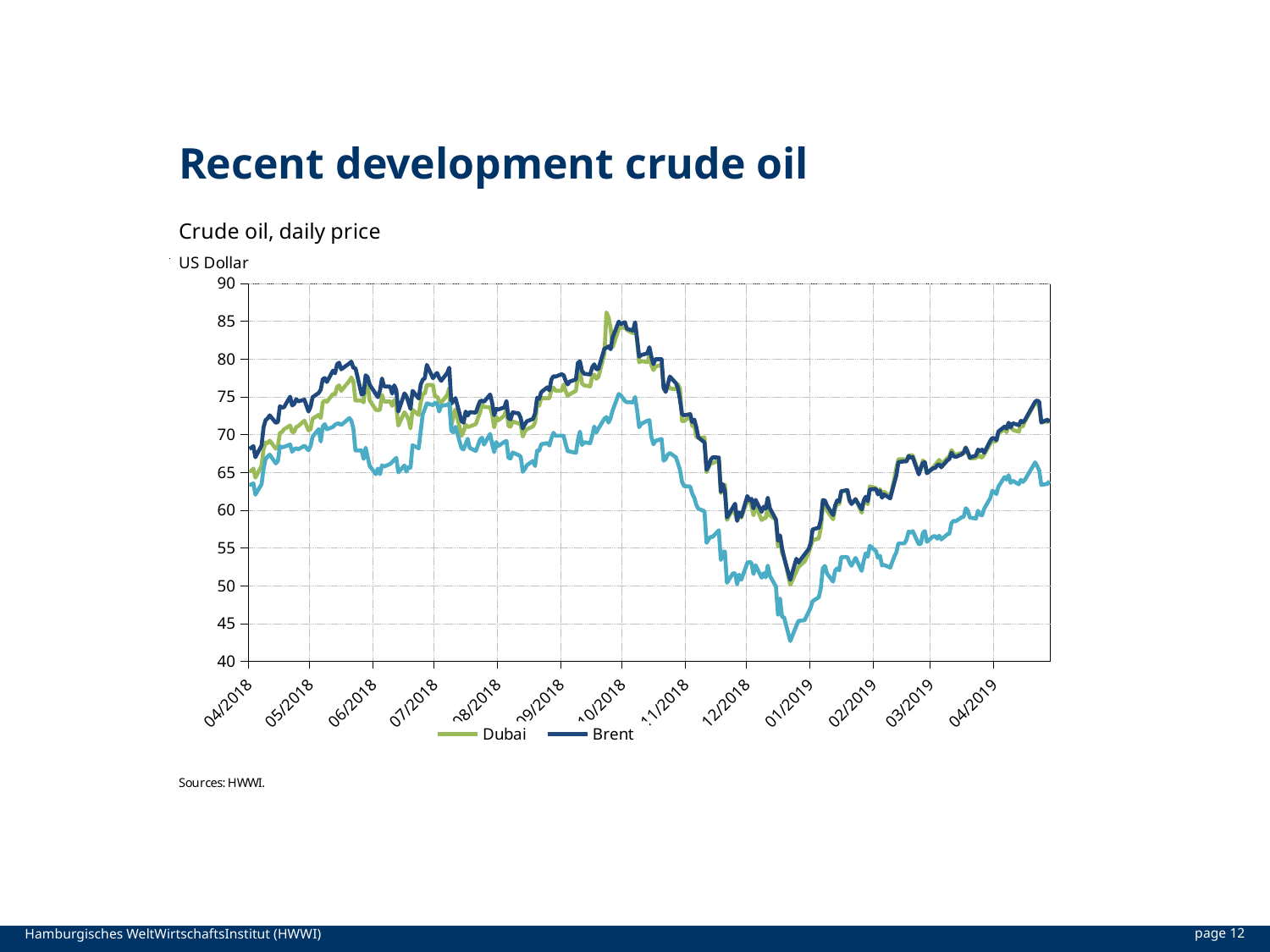
Is the value for Dubai at 04/2018 greater or less than 70? less Is the lowest value reached by Brent greater or less than 55? less What kind of chart is shown on the slide? line chart How many series does the chart legend list? 2 At 05/2018, which is higher, Brent or Dubai? Brent Is the highest value reached by Brent greater or less than 80? greater What unit is shown on the y axis of the chart? US Dollar What is the title of the chart? Crude oil, daily price Does the Brent price rise or fall between 10/2018 and 12/2018? fall Does the Brent price rise or fall between 01/2019 and 04/2019? rise